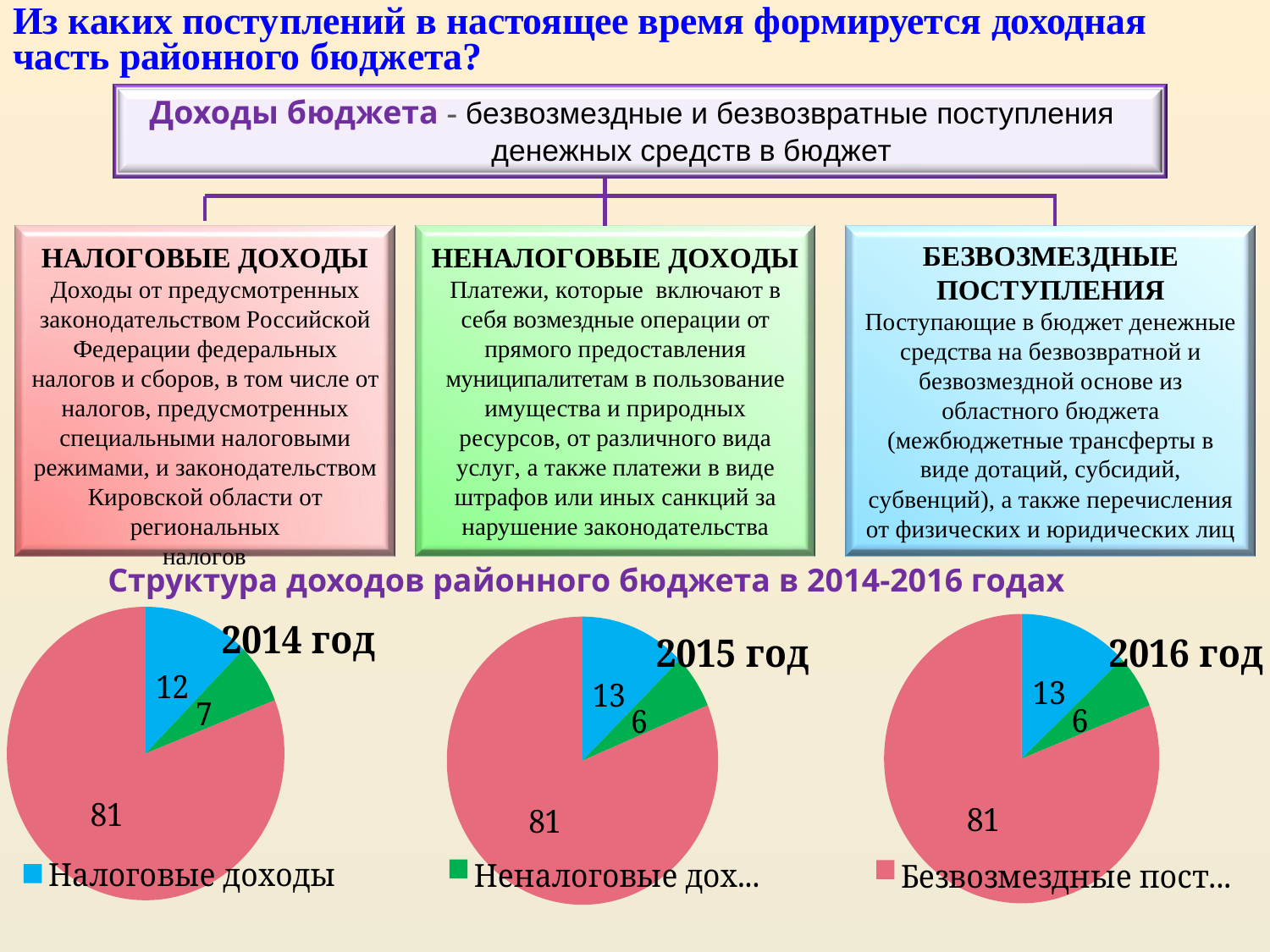
In the 2014 год pie chart, what is the difference between the values for Безвозмездные поступления and Налоговые доходы? 69 Which colour represents Налоговые доходы in the pie charts? Blue How many pie charts are shown on the slide? 3 In the 2015 год pie chart, which category has the smallest slice? Неналоговые доходы How many slices does the 2016 год pie chart have? 3 In the 2016 год pie chart, what is the value for Безвозмездные поступления? 81 In the 2014 год pie chart, what is the value for Неналоговые доходы? 7 What type of chart is used to show the 2014 год budget structure? Pie chart In the 2014 год pie chart, what is the value for Налоговые доходы? 12 In the 2015 год pie chart, which is larger: Налоговые доходы or Неналоговые доходы? Налоговые доходы In the 2016 год pie chart, which category has the largest slice? Безвозмездные поступления In the 2015 год pie chart, what is the value for Налоговые доходы? 13